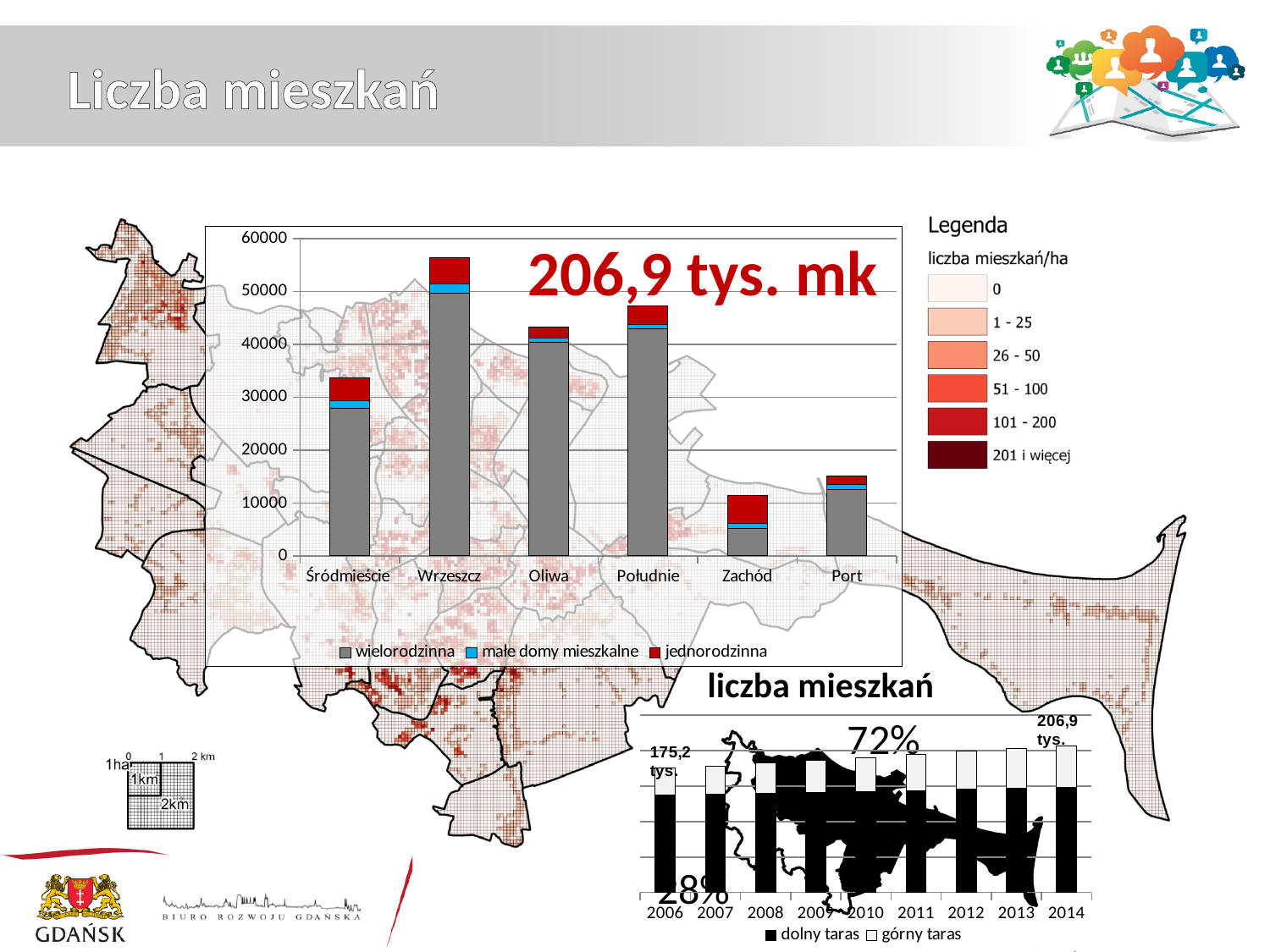
In the top stacked bar chart, which bar is taller, Południe or Oliwa? Południe In the bottom chart titled 'liczba mieszkań', what value is labelled for 2014? 206,9 tys. In the top stacked bar chart, is the total bar for Śródmieście greater or less than 30000? greater In the bottom chart titled 'liczba mieszkań', how many years are shown on the x axis? 9 In the top stacked bar chart, which district has the shortest bar? Zachód In the top stacked bar chart, is the total bar for Port greater or less than 20000? less In the top stacked bar chart, how many series does the legend list? 3 What kind of chart is the top chart with districts Śródmieście to Port? bar chart In the top stacked bar chart, how many districts are shown on the x axis? 6 In the top stacked bar chart, which series is shown in grey? wielorodzinna In the top stacked bar chart, which district has the tallest bar? Wrzeszcz In the top stacked bar chart, is the total bar for Wrzeszcz greater or less than 50000? greater